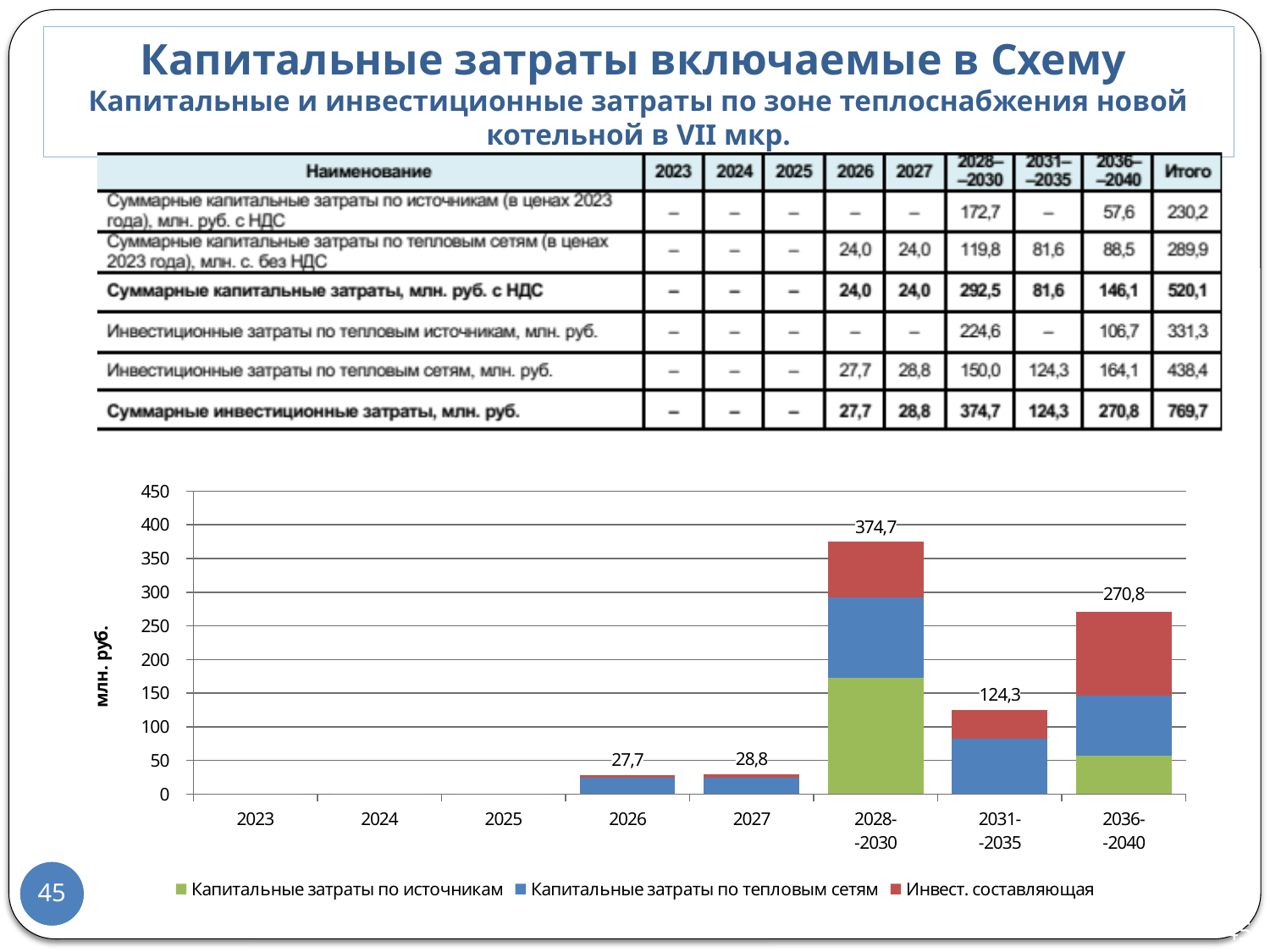
How many series does the chart legend list? 3 What is the difference between the total for 2028–2030 and the total for 2036–2040? 103,9 What is the total value labelled on the bar for 2031–2035? 124,3 Is the green segment (Капитальные затраты по источникам) for 2028–2030 greater or less than 150? greater What is the label of the y axis of the chart? млн. руб. Which period has the highest total bar in the chart? 2028–2030 How many categories are shown on the x axis of the chart? 8 What is the total value labelled on the bar for 2026? 27,7 What is the total value labelled on the bar for 2028–2030? 374,7 Which total is larger: 2027 or 2031–2035? 2031–2035 What kind of chart is shown on the slide? stacked bar chart What is the total value labelled on the bar for 2036–2040? 270,8